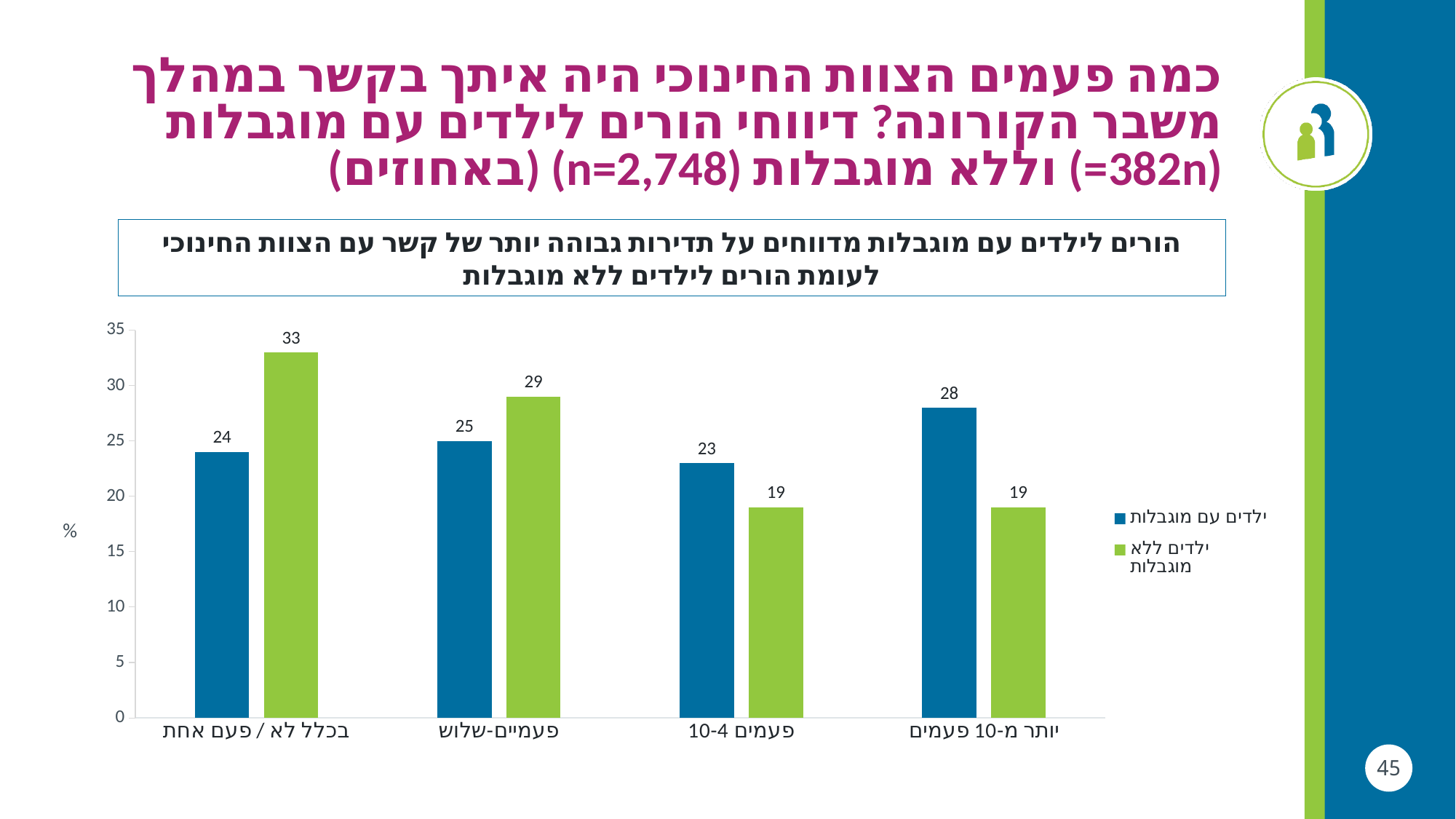
What is the value for "ילדים ללא מוגבלות" in the category "4-10 פעמים"? 19 Is the value for "ילדים ללא מוגבלות" in the category "פעמיים-שלוש" greater or less than 25? greater What kind of chart is shown on the slide? bar chart How many categories are shown on the x axis? 4 In the category "יותר מ-10 פעמים", which series has the larger value? ילדים עם מוגבלות What is the value for "ילדים ללא מוגבלות" in the category "בכלל לא / פעם אחת"? 33 In which category is the value for "ילדים ללא מוגבלות" highest? בכלל לא / פעם אחת What is the value for "ילדים עם מוגבלות" in the category "פעמיים-שלוש"? 25 In which category is the value for "ילדים עם מוגבלות" lowest? 10-4 פעמים What is the difference between "ילדים ללא מוגבלות" and "ילדים עם מוגבלות" in the category "בכלל לא / פעם אחת"? 9 How many series does the legend list? 2 What is the value for "ילדים עם מוגבלות" in the category "יותר מ-10 פעמים"? 28